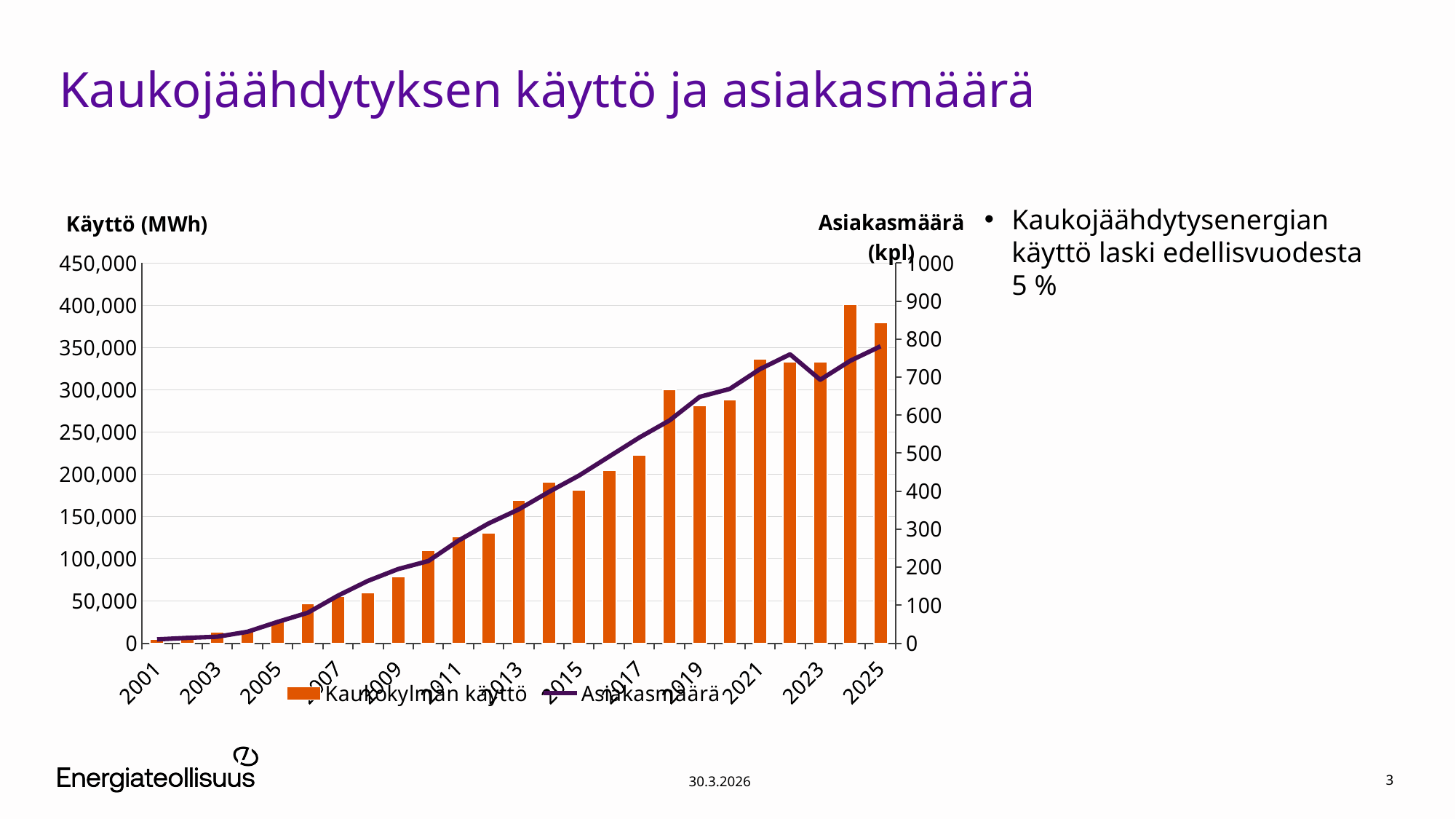
Is the Kaukokylmän käyttö bar for 2009 greater or less than 100,000? less Is the Kaukokylmän käyttö bar for 2025 greater or less than 400,000? less How many years (bars) are plotted on the x axis? 25 Which year has the highest bar for Kaukokylmän käyttö? 2024 What kind of chart is shown on the slide? A combined bar and line chart Is the Asiakasmäärä value for 2022 greater or less than 700? greater Does the Asiakasmäärä line generally rise or fall from 2001 to 2022? rise Which year has the larger Kaukokylmän käyttö bar, 2024 or 2025? 2024 Which year has the larger Kaukokylmän käyttö bar, 2019 or 2020? 2020 How many series does the legend list? 2 What is the title of the left vertical axis? Käyttö (MWh)